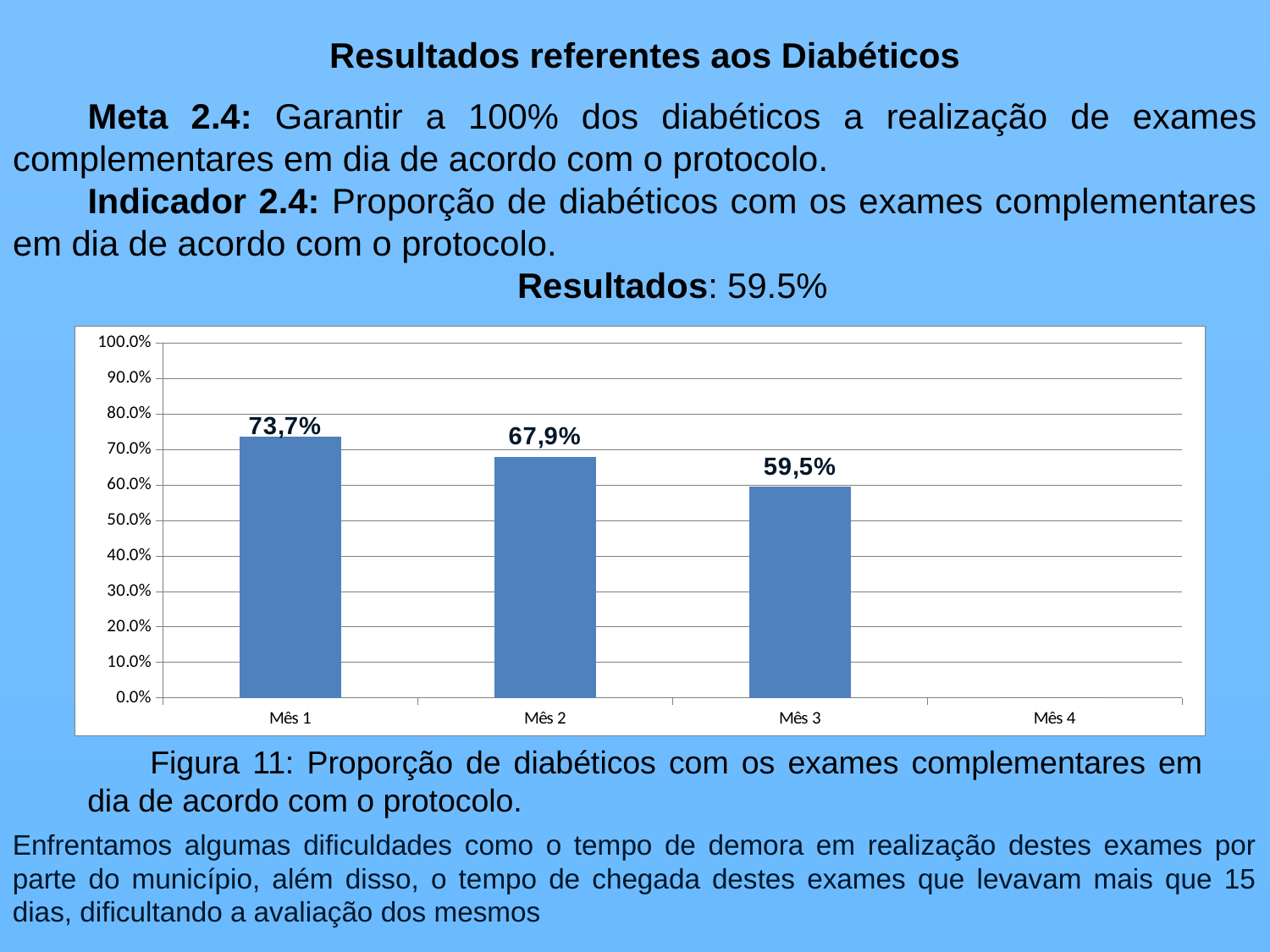
What is the value for Mês 1? 73,7% Which is larger, the value for Mês 2 or the value for Mês 3? Mês 2 Is the value for Mês 3 greater or less than 60.0%? less What is the value for Mês 3? 59,5% Which month with a plotted bar has the lowest value? Mês 3 Do the values rise or fall from Mês 1 to Mês 3? fall What is the difference between the values for Mês 1 and Mês 2? 5,8% What is the difference between the values for Mês 1 and Mês 3? 14,2% Which month has the highest value? Mês 1 What is the value for Mês 2? 67,9% What kind of chart is shown on the slide? bar chart How many categories are labelled on the x axis? 4